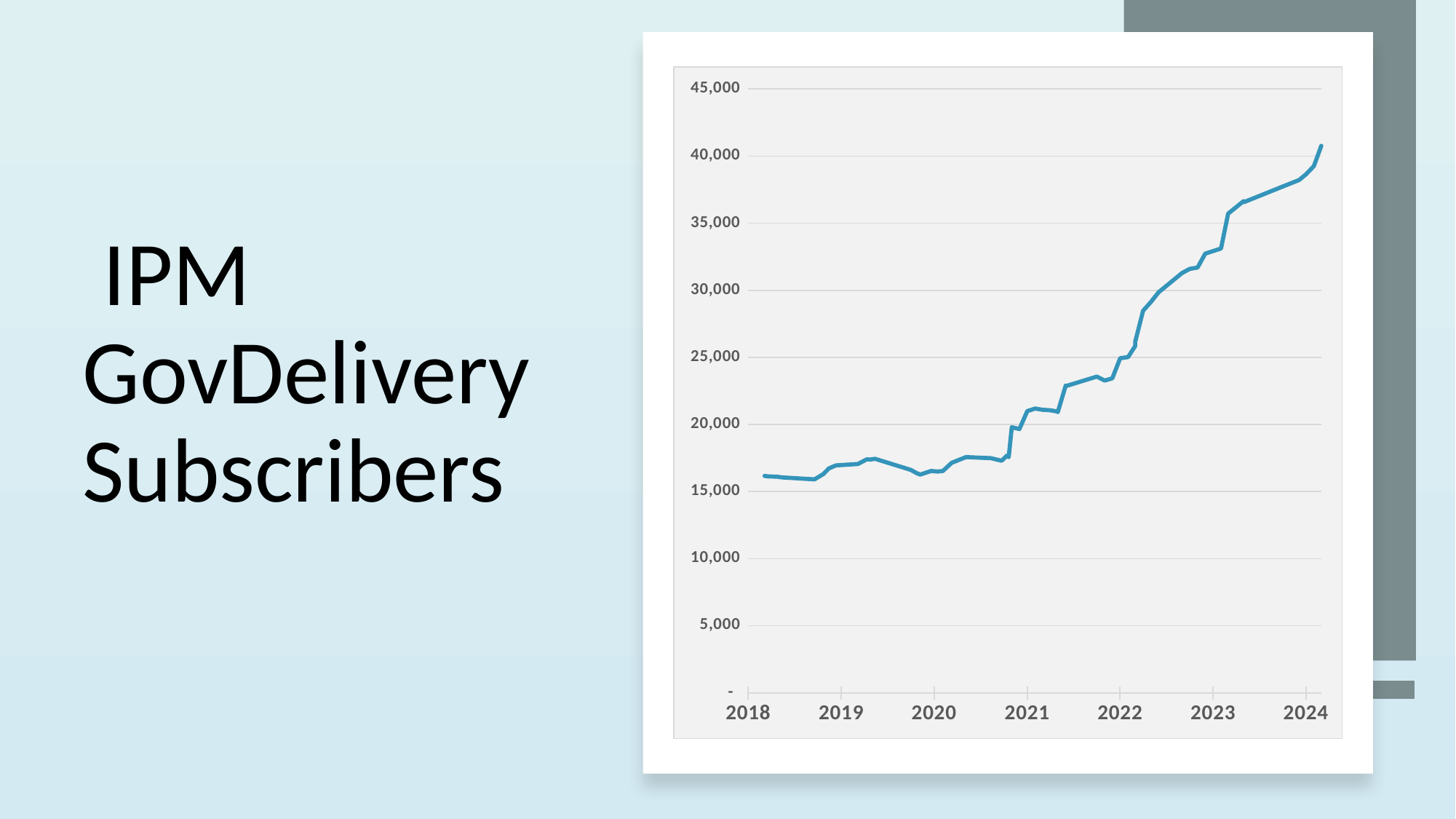
In which year does the line reach its highest value? 2024 Is the value at 2023 greater or less than 30,000? greater Is the value at the start of 2018 greater or less than 15,000? greater What is the title text on the slide describing the chart? IPM GovDelivery Subscribers Is the value at 2019 greater or less than 20,000? less What kind of chart is shown on the slide? line chart What is the highest value shown on the vertical axis? 45,000 Overall, do the subscriber values rise or fall from 2018 to 2024? rise Which is larger, the value at 2023 or the value at 2019? 2023